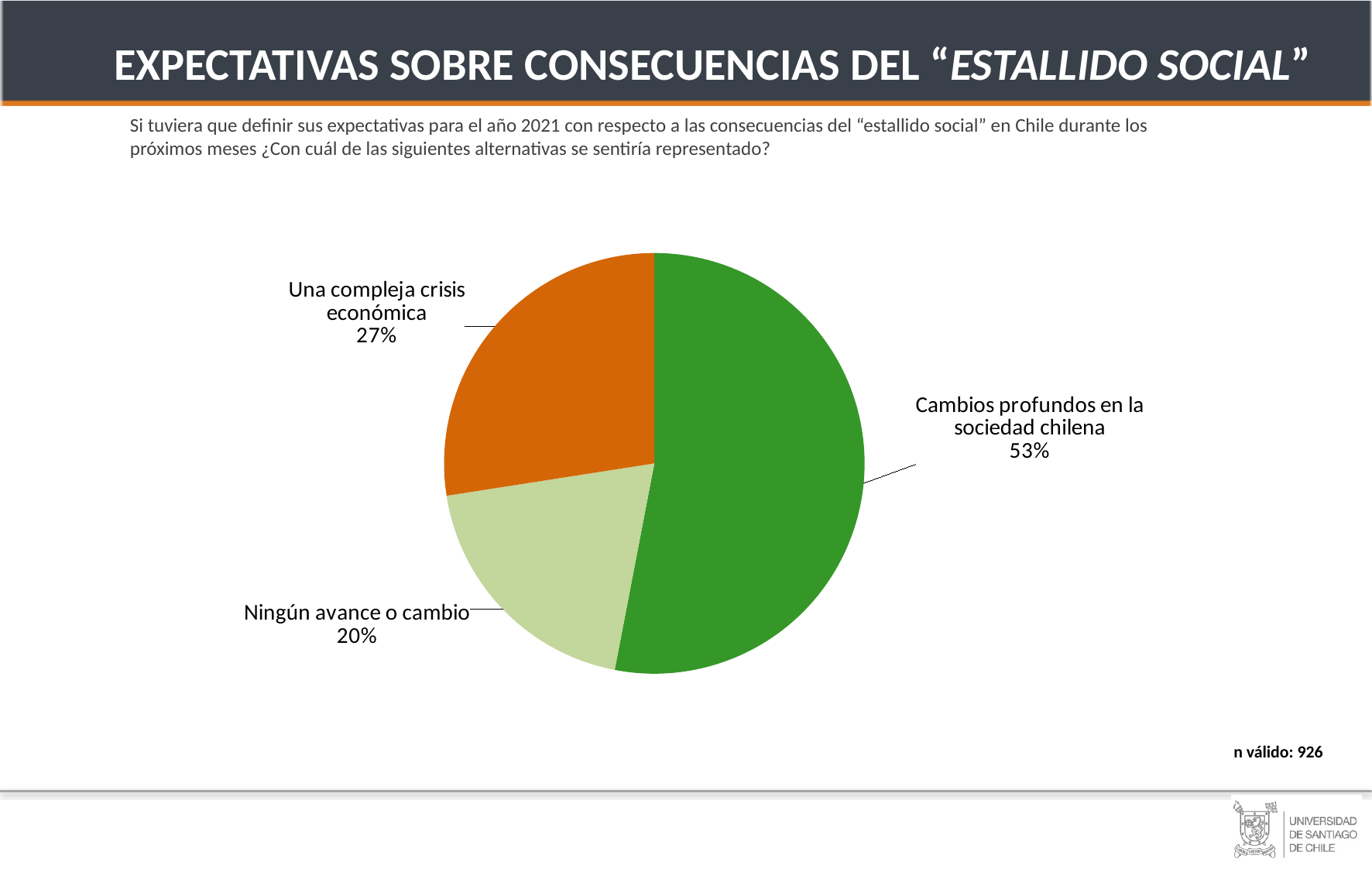
What kind of chart is shown on the slide? Pie chart What is the difference in percentage points between "Una compleja crisis económica" and "Ningún avance o cambio"? 7 percentage points Which category has the smallest share of the pie? Ningún avance o cambio What percentage of respondents chose "Una compleja crisis económica"? 27% What percentage of respondents chose "Cambios profundos en la sociedad chilena"? 53% Which is larger: the share for "Una compleja crisis económica" or the share for "Ningún avance o cambio"? Una compleja crisis económica Which category has the largest share of the pie? Cambios profundos en la sociedad chilena What percentage of respondents chose "Ningún avance o cambio"? 20% What is the difference in percentage points between "Cambios profundos en la sociedad chilena" and "Una compleja crisis económica"? 26 percentage points What is the valid sample size (n válido) shown on the slide? 926 What colour is the slice for "Cambios profundos en la sociedad chilena"? Green How many categories (slices) does the pie chart have? 3